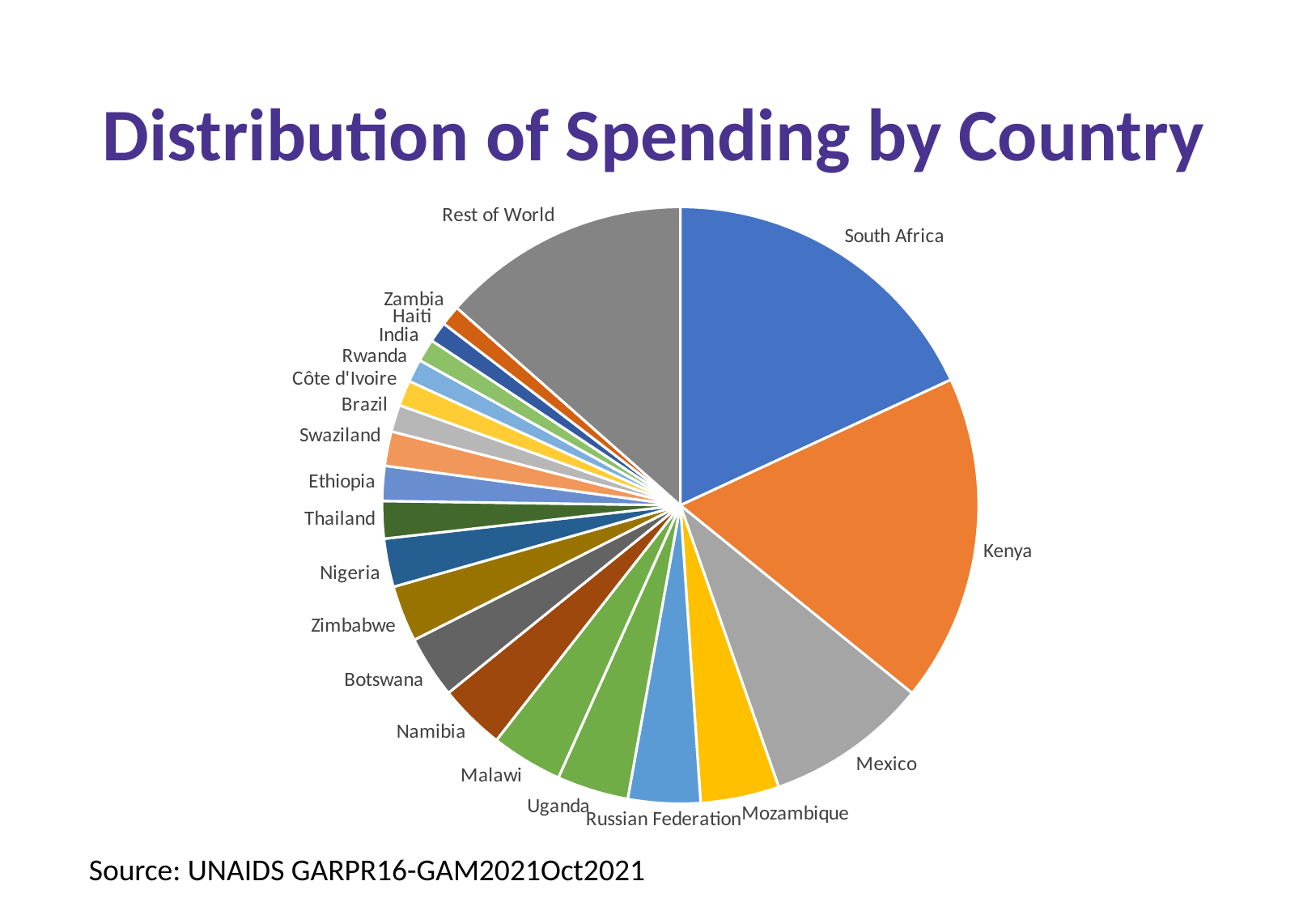
Which slice is larger, Mexico or Uganda? Mexico What is the title of the chart? Distribution of Spending by Country What kind of chart is shown on the slide? pie chart Which slice is larger, South Africa or Mozambique? South Africa What source is cited below the chart? UNAIDS GARPR16-GAM2021Oct2021 Which slice is larger, Botswana or Brazil? Botswana How many slices does the pie chart have? 21